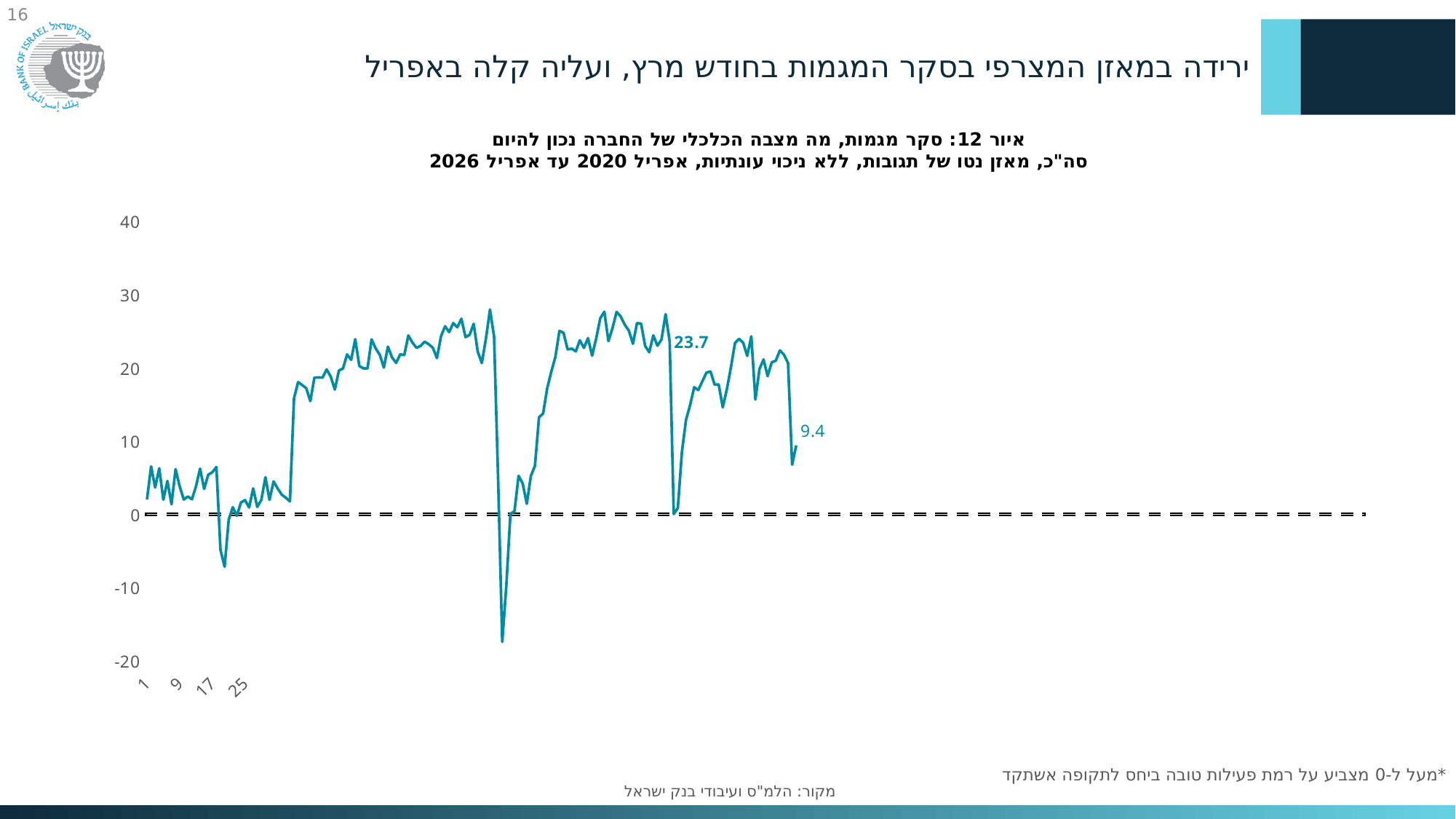
Does the line rise or fall between the labelled point 23.7 and the labelled point 9.4? fall What is the difference between the two labelled values on the line, 23.7 and 9.4? 14.3 Is the lowest point of the line greater or less than -10? less What is the value of the earlier labelled point on the line, shown near the middle-right of the chart? 23.7 Is the highest point of the line greater or less than 20? greater Is the value at the start of the series (leftmost point) greater or less than 10? less At what value is the horizontal dashed reference line drawn? 0 What kind of chart is shown on the slide? line chart What is the value of the last labelled point on the line (the most recent observation)? 9.4 What is the highest value shown on the vertical axis? 40 Which of the two labelled values is larger, 23.7 or 9.4? 23.7